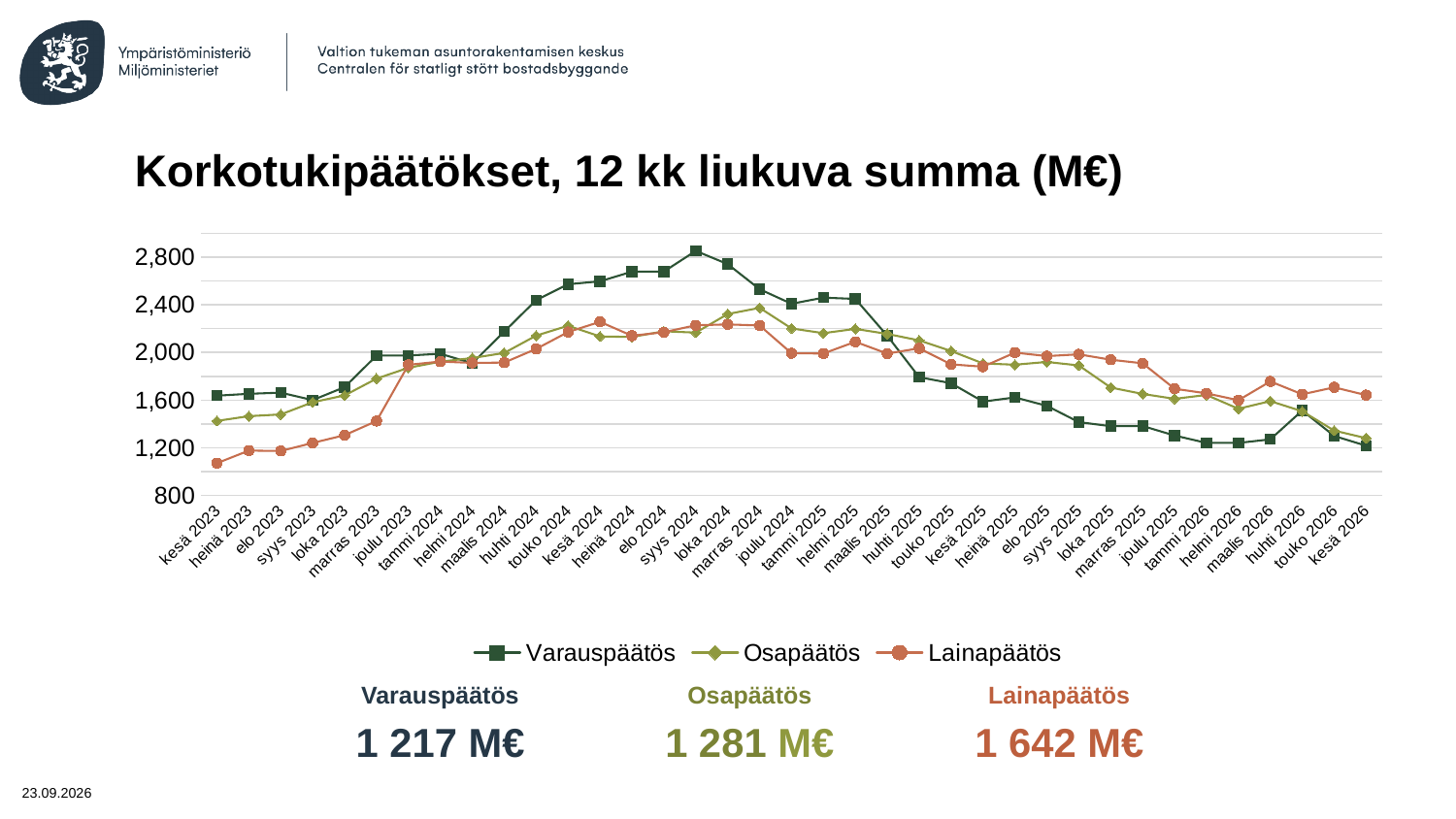
What is the title of the chart? Korkotukipäätökset, 12 kk liukuva summa (M€) What is the difference between the latest values of Lainapäätös and Varauspäätös? 425 M€ What kind of chart is shown on the slide? line chart Is the value for Lainapäätös at kesä 2023 greater or less than 1,200? less How many series does the legend list? 3 What is the latest value shown for Lainapäätös? 1 642 M€ What is the latest value shown for Varauspäätös? 1 217 M€ What is the latest value shown for Osapäätös? 1 281 M€ Which series reaches the highest peak on the chart? Varauspäätös Which series has the highest latest value shown below the chart? Lainapäätös Does the Varauspäätös line rise or fall from syys 2024 to kesä 2026? fall How many time points are plotted along the x axis, from kesä 2023 to kesä 2026? 37